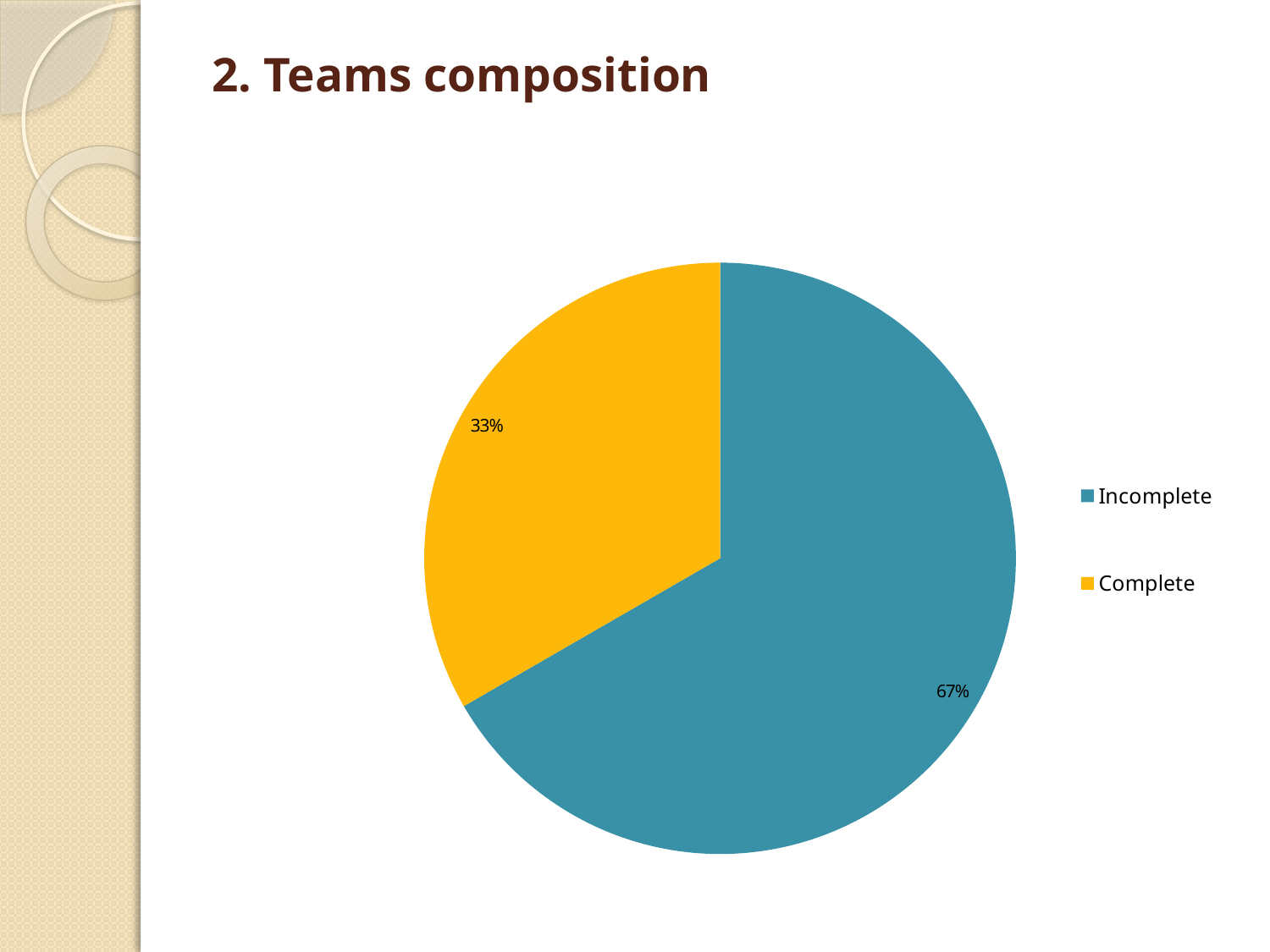
Which is larger, the Incomplete slice or the Complete slice? Incomplete What kind of chart is shown on the slide? pie chart What is the difference in percentage points between the Incomplete and Complete slices? 34 What share of the pie does the Incomplete slice represent? 67% How many entries does the legend list? 2 How many slices does the pie chart have? 2 Which category has the smallest slice of the pie? Complete What colour is the Complete slice? yellow What is the title of the slide containing the pie chart? 2. Teams composition What share of the pie does the Complete slice represent? 33% Which category has the largest slice of the pie? Incomplete